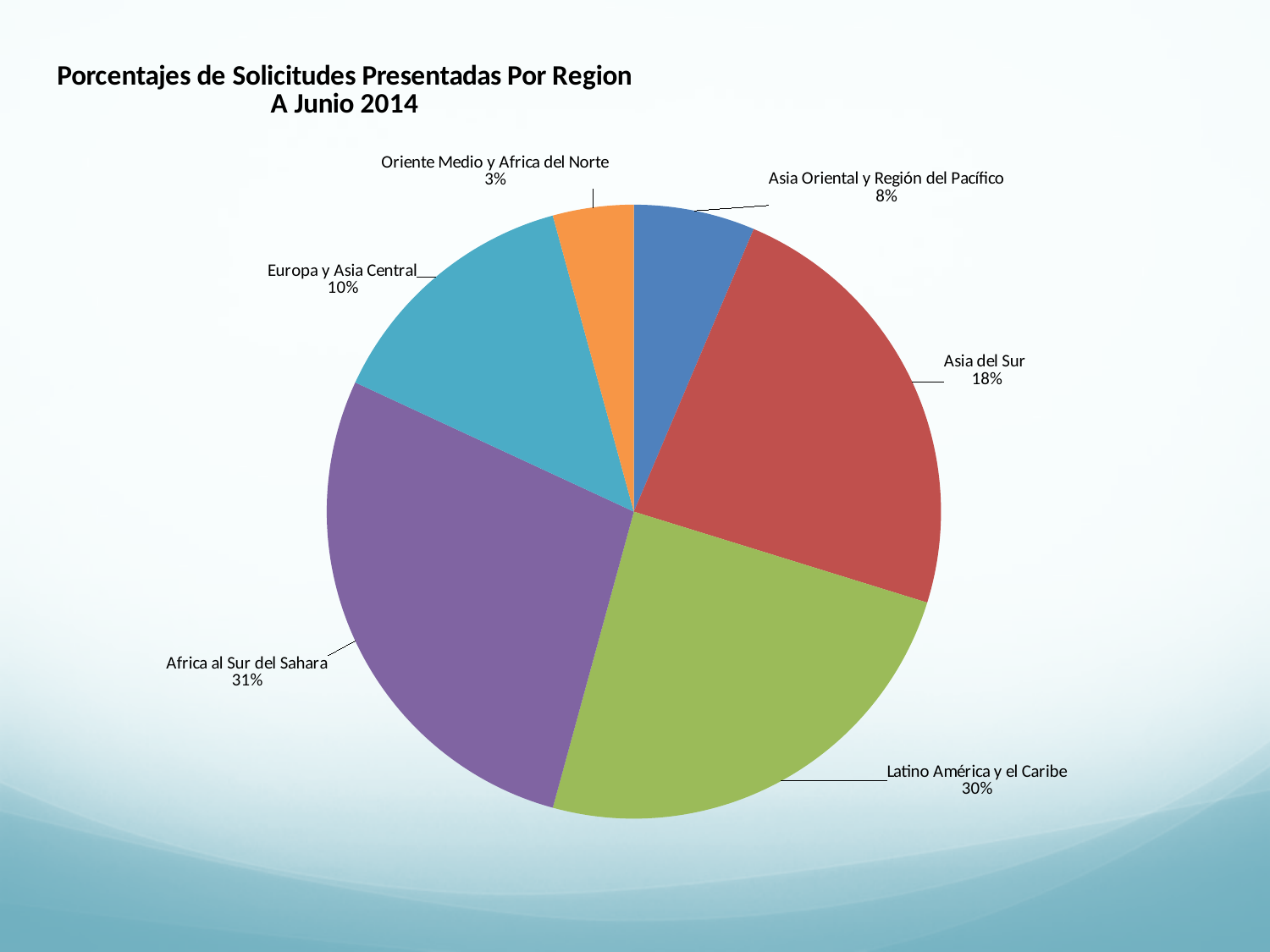
Which region has the smallest share of the pie? Oriente Medio y Africa del Norte What type of chart is shown on the slide? pie chart What percentage is shown for Latino América y el Caribe? 30% What percentage is shown for Asia Oriental y Región del Pacífico? 8% How many regions are shown in the pie chart? 6 What percentage of applications is shown for Asia del Sur? 18% What percentage is shown for Europa y Asia Central? 10% What is the title of the chart? Porcentajes de Solicitudes Presentadas Por Region A Junio 2014 Which is larger, the share for Asia del Sur or the share for Asia Oriental y Región del Pacífico? Asia del Sur What percentage is shown for Oriente Medio y Africa del Norte? 3% What is the difference in percentage points between Asia del Sur and Europa y Asia Central? 8 Which region has the largest share of the pie? Africa al Sur del Sahara